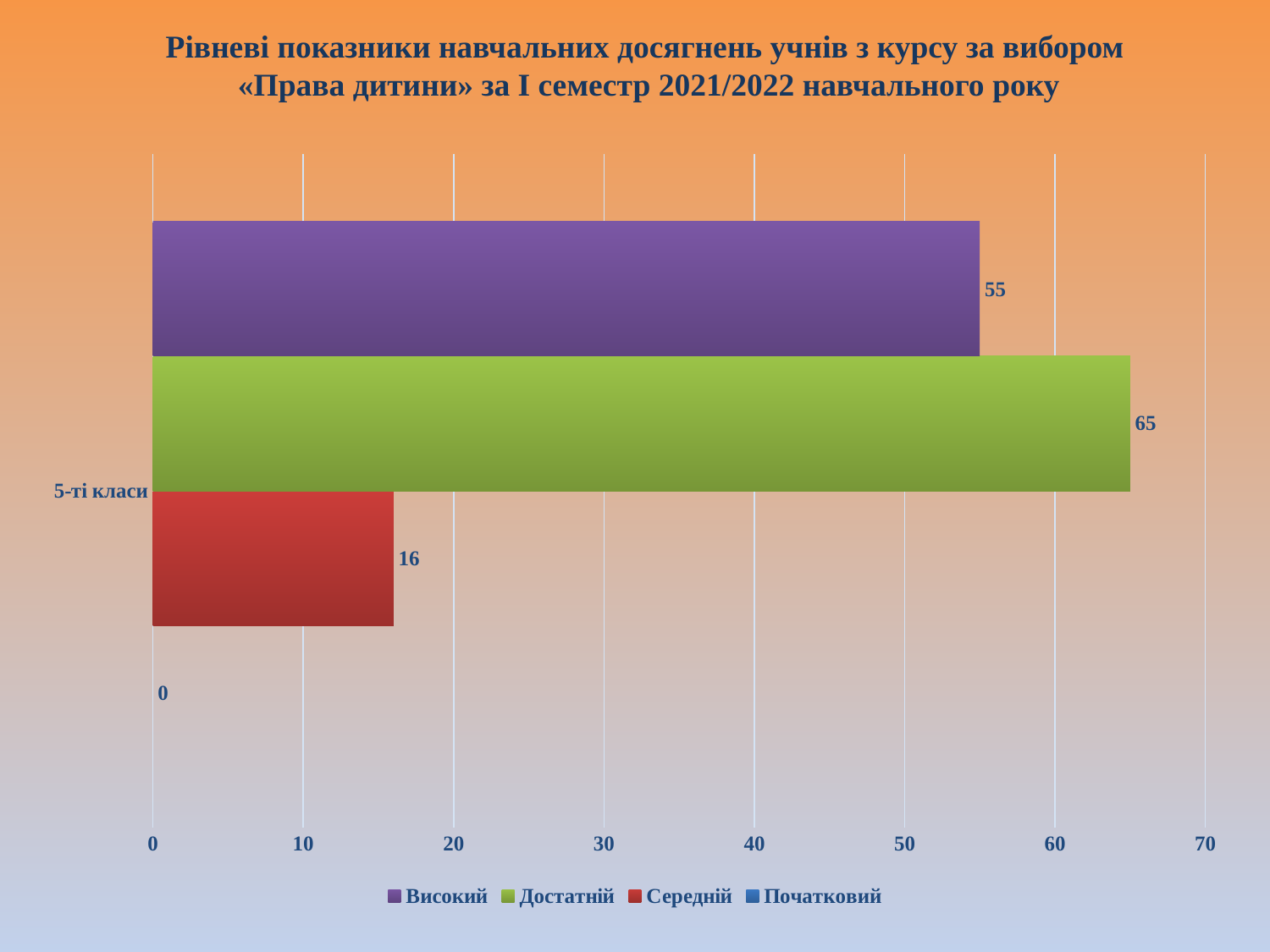
What is the value for the Достатній series for 5-ті класи? 65 What kind of chart is shown on the slide? Bar chart What is the value for the Високий series for 5-ті класи? 55 What is the difference between the Високий and Середній values for 5-ті класи? 39 What is the value for the Початковий series for 5-ті класи? 0 Which series has the lowest value for 5-ті класи? Початковий Which is larger for 5-ті класи: Високий or Середній? Високий What colour is the bar for the Достатній series? Green What is the value for the Середній series for 5-ті класи? 16 What is the difference between the Достатній and Високий values for 5-ті класи? 10 How many series does the legend list? 4 Which series has the highest value for 5-ті класи? Достатній